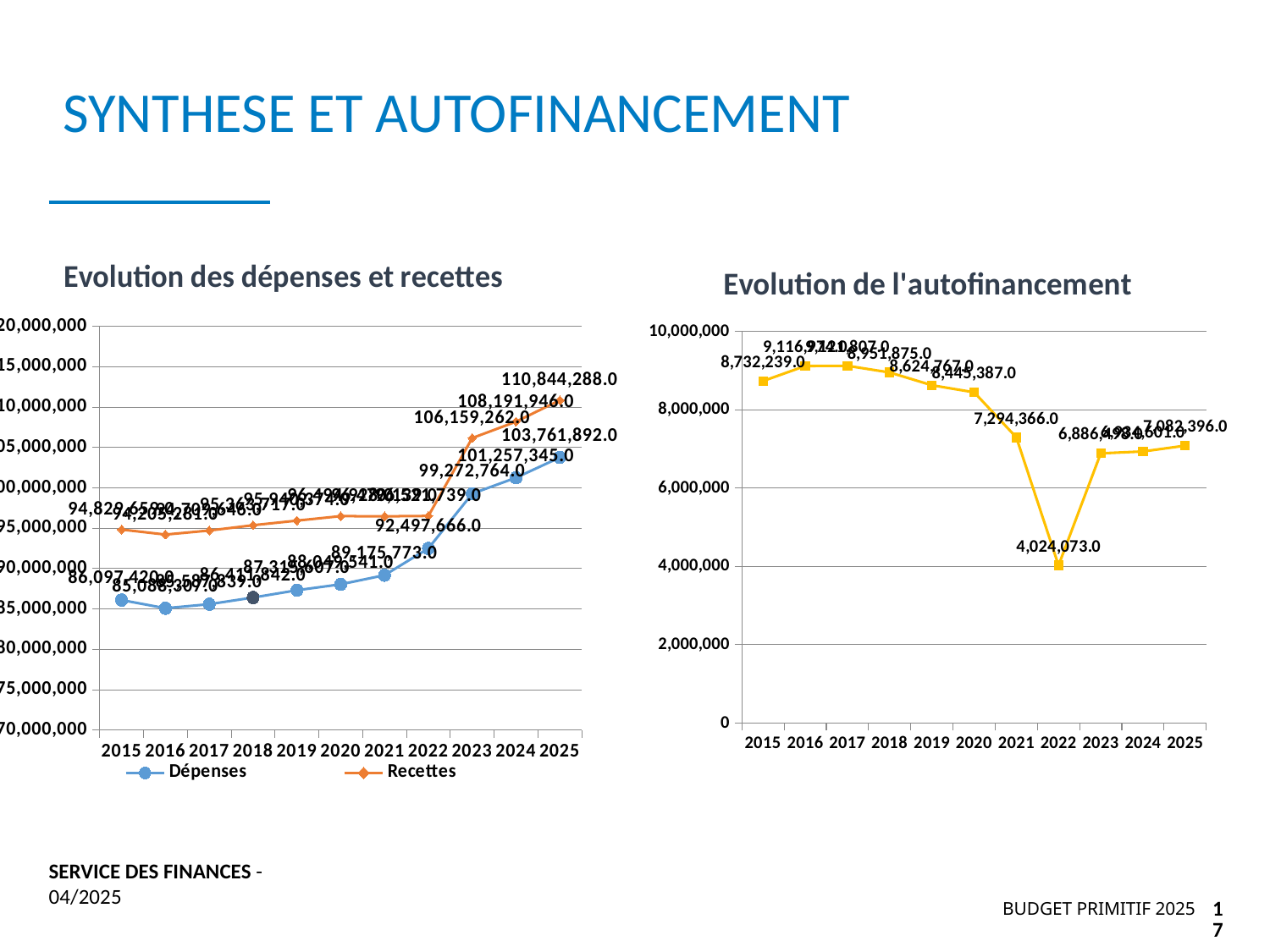
In the 'Evolution de l'autofinancement' chart, what is the value for 2022? 4,024,073.0 In the 'Evolution de l'autofinancement' chart, how many years are plotted? 11 In the 'Evolution des dépenses et recettes' chart, what is the Recettes value for 2025? 110,844,288.0 In the 'Evolution des dépenses et recettes' chart, which series is higher in 2024, Dépenses or Recettes? Recettes In the 'Evolution des dépenses et recettes' chart, what is the Dépenses value for 2025? 103,761,892.0 In the 'Evolution de l'autofinancement' chart, which year has the lowest value? 2022 In the 'Evolution de l'autofinancement' chart, do the values rise or fall from 2017 to 2022? fall How many series does the legend of the 'Evolution des dépenses et recettes' chart list? 2 In the 'Evolution de l'autofinancement' chart, what is the value for 2021? 7,294,366.0 What kind of chart is 'Evolution de l'autofinancement'? line chart In the 'Evolution des dépenses et recettes' chart, what is the difference between Recettes and Dépenses in 2025? 7,082,396.0 In the 'Evolution de l'autofinancement' chart, what is the value for 2015? 8,732,239.0